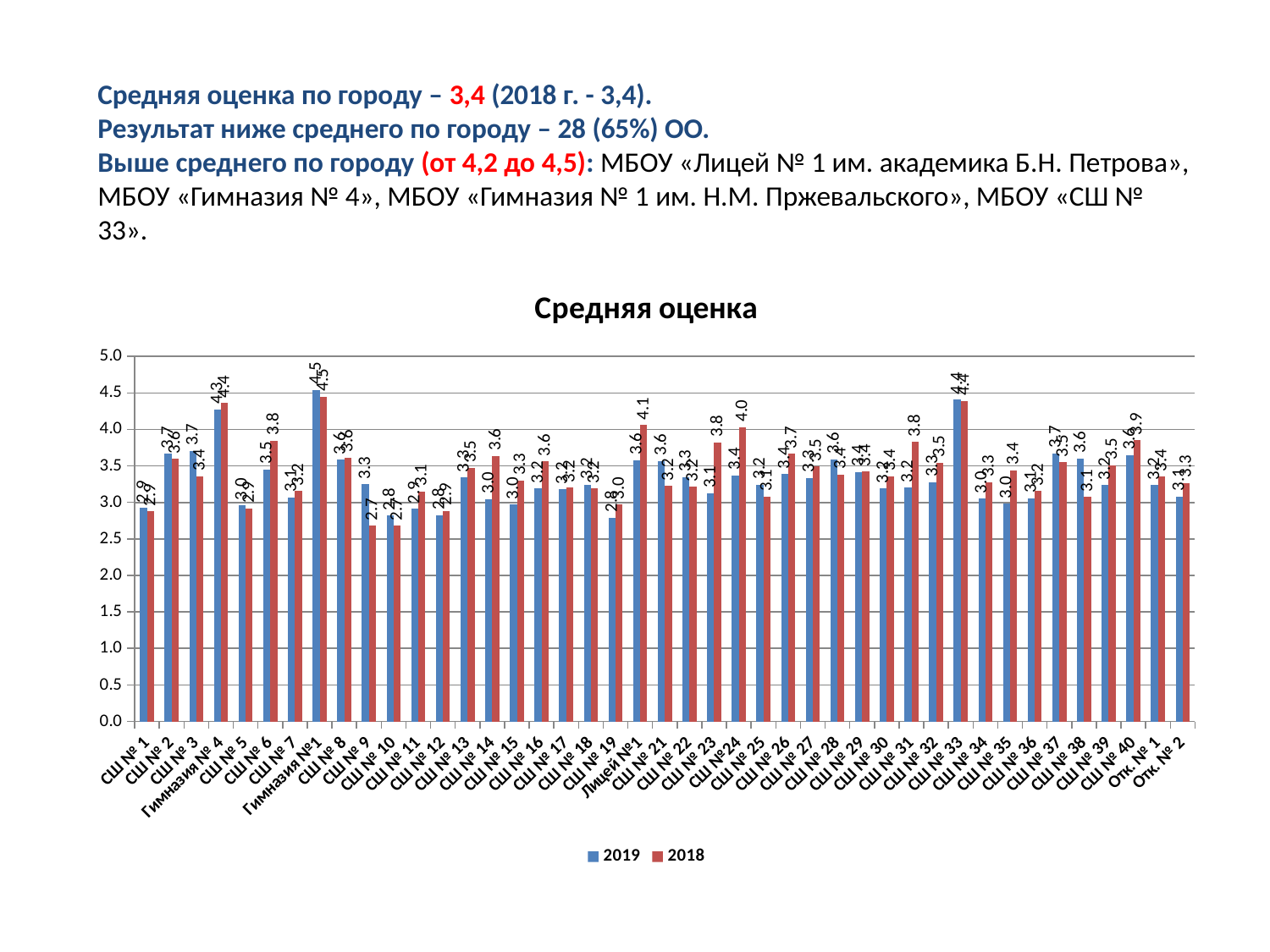
What is the 2018 value for СШ № 9? 2.7 What kind of chart is shown on the slide? bar chart What is the difference between the 2018 and 2019 values for Лицей №1? 0.5 For СШ № 9, which year has the larger value, 2019 or 2018? 2019 What is the 2018 value for Лицей №1? 4.1 What is the 2019 value for Гимназия №1? 4.5 How many series does the legend list? 2 What is the title of the chart? Средняя оценка Which category has the highest 2019 value? Гимназия №1 What is the 2018 value for СШ №24? 4.0 Is the 2019 value for Гимназия №1 greater or less than 4.0? greater What is the 2019 value for СШ № 33? 4.4